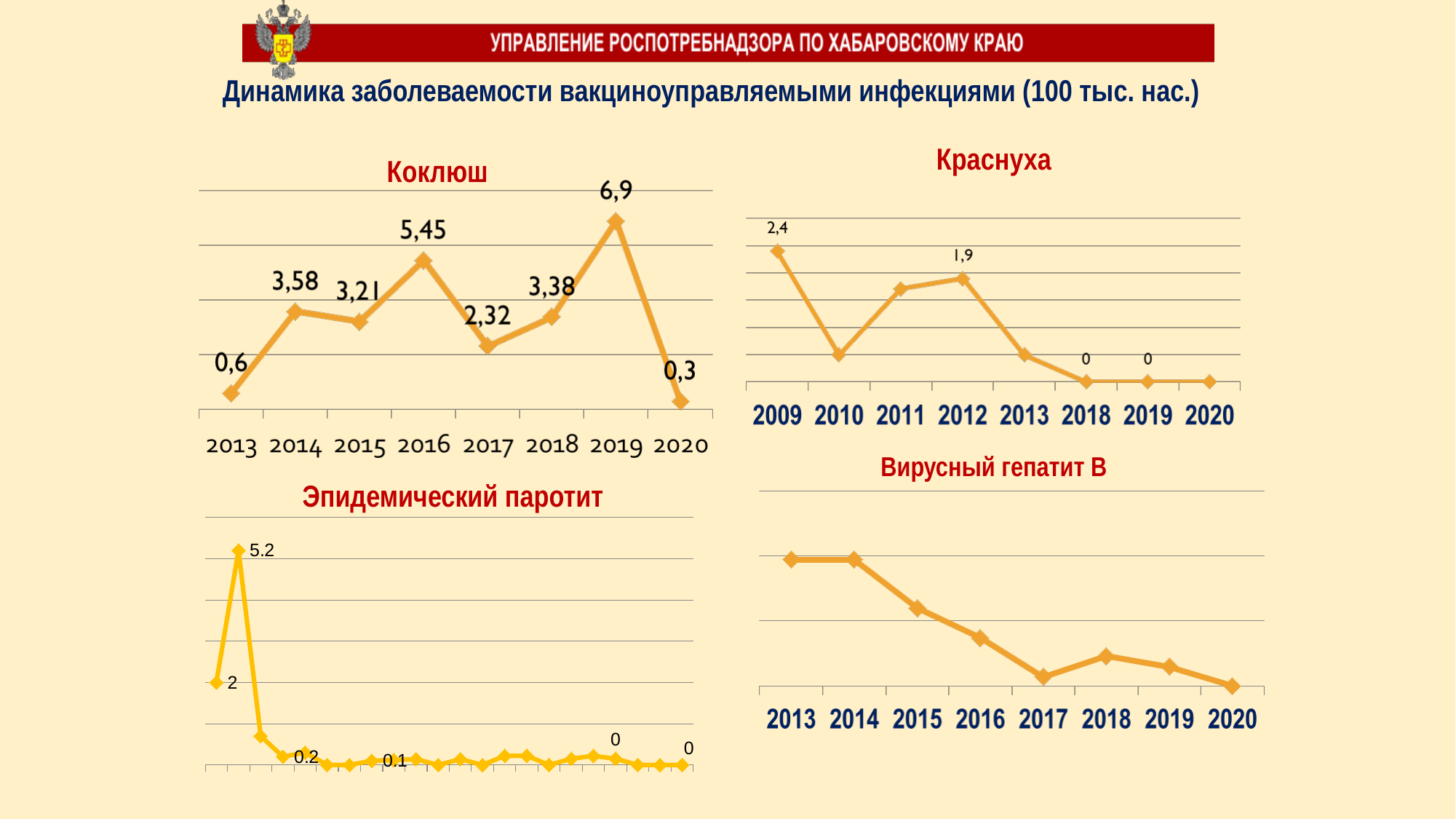
In the Краснуха chart, what is the value for 2018? 0 In the Коклюш chart, what is the difference between the values for 2019 and 2020? 6,6 In the Коклюш chart, which year has the larger value, 2016 or 2017? 2016 In the Коклюш chart, what is the value for 2019? 6,9 What kind of chart is the Вирусный гепатит В chart? line chart In the Краснуха chart, what is the value for 2012? 1,9 In the Коклюш chart, which year has the lowest value? 2020 In the Краснуха chart, what is the value for 2009? 2,4 In the Коклюш chart, which year has the highest value? 2019 How many years are plotted in the Коклюш chart? 8 In the Вирусный гепатит В chart, do the values generally rise or fall from 2013 to 2020? fall In the Коклюш chart, what is the value for 2013? 0,6